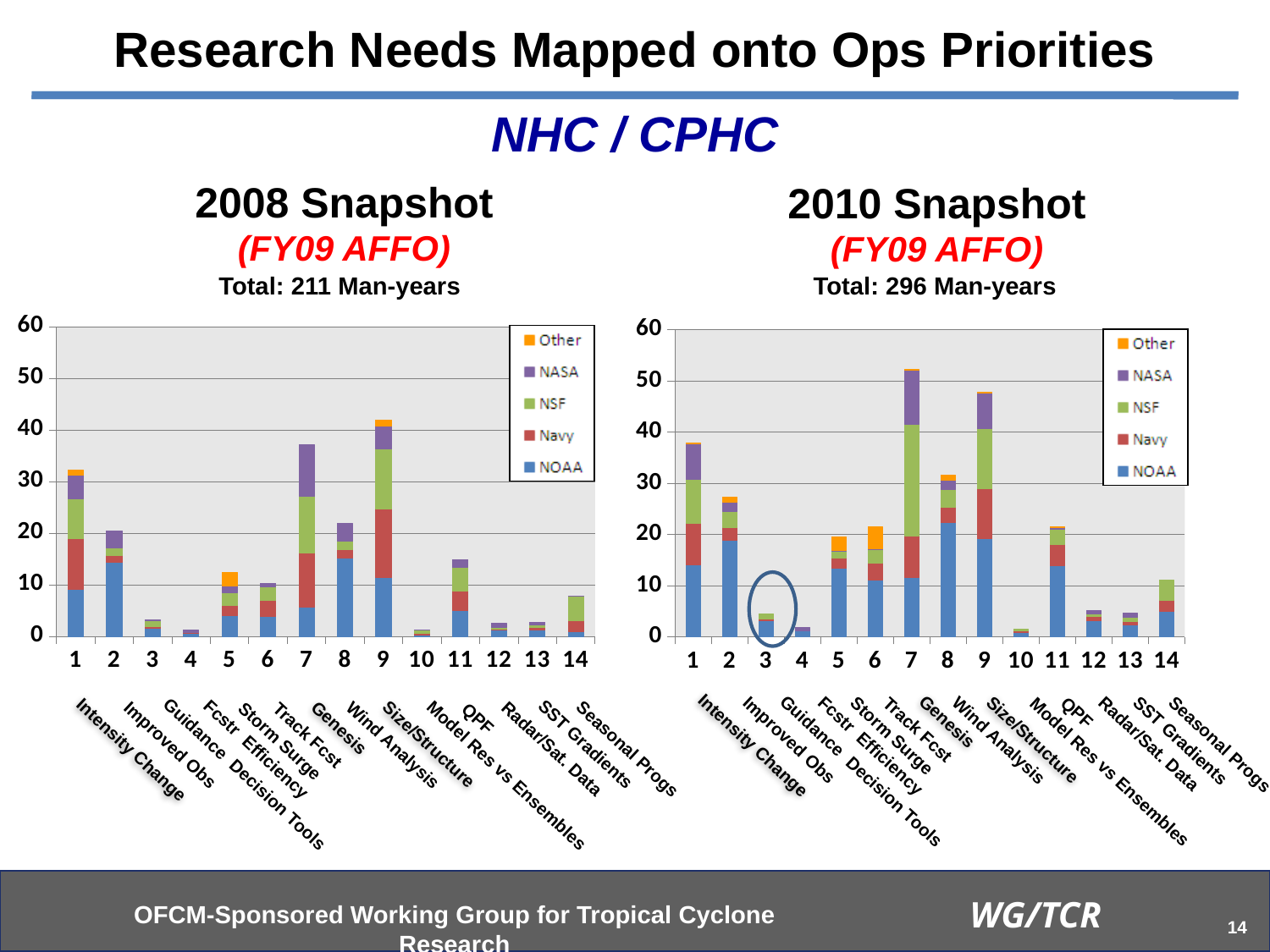
In the 2010 Snapshot chart, which category has the tallest stacked bar? 7 In the 2008 Snapshot chart, is the total for category 9 (Wind Analysis) greater or less than 40? greater Which series is shown in blue in the legend of the 2008 Snapshot chart? NOAA In the 2010 Snapshot chart, which has the taller stacked bar: category 1 (Intensity Change) or category 2 (Improved Obs)? 1 (Intensity Change) In the 2010 Snapshot chart, is the total for category 3 (Guidance Decision Tools) greater or less than 10? less In the 2008 Snapshot chart, which category has the tallest stacked bar? 9 How many series does the legend of the 2010 Snapshot chart list? 5 In the 2010 Snapshot chart, is the total for category 1 (Intensity Change) greater or less than 30? greater What kind of chart is the 2008 Snapshot chart? stacked bar chart In the 2008 Snapshot chart, which has the taller stacked bar: category 7 (Genesis) or category 1 (Intensity Change)? 7 (Genesis) How many categories are plotted on the x axis of the 2008 Snapshot chart? 14